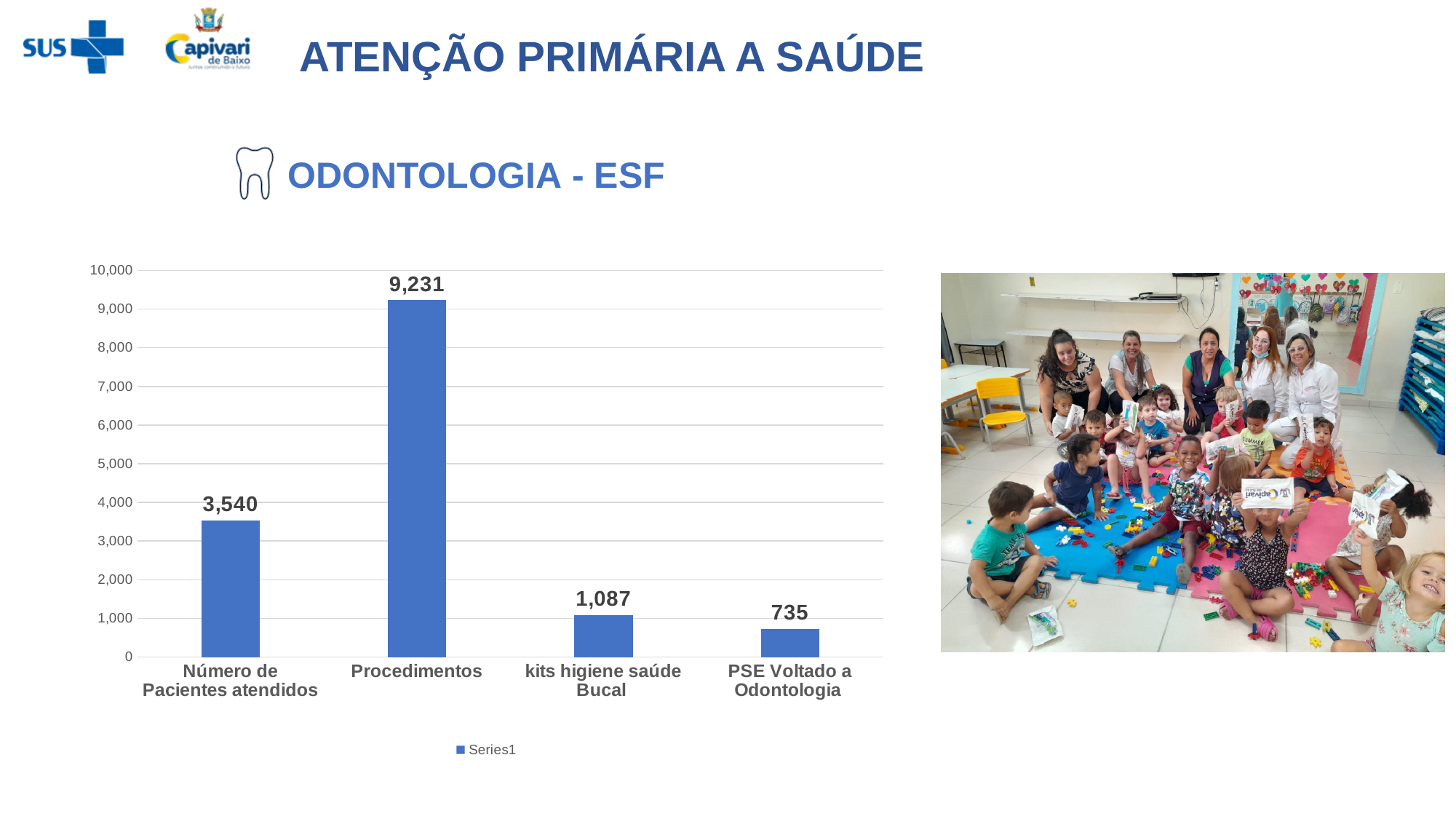
What is the value for Número de Pacientes atendidos? 3,540 What is the legend entry shown below the chart? Series1 Which category has the highest value? Procedimentos Which is larger, Número de Pacientes atendidos or kits higiene saúde Bucal? Número de Pacientes atendidos What is the value for kits higiene saúde Bucal? 1,087 What kind of chart is shown on the slide? Bar chart What is the difference between kits higiene saúde Bucal and PSE Voltado a Odontologia? 352 What is the value for Procedimentos? 9,231 What is the difference between Procedimentos and Número de Pacientes atendidos? 5,691 What is the value for PSE Voltado a Odontologia? 735 How many categories are shown on the x axis? 4 Which category has the lowest value? PSE Voltado a Odontologia